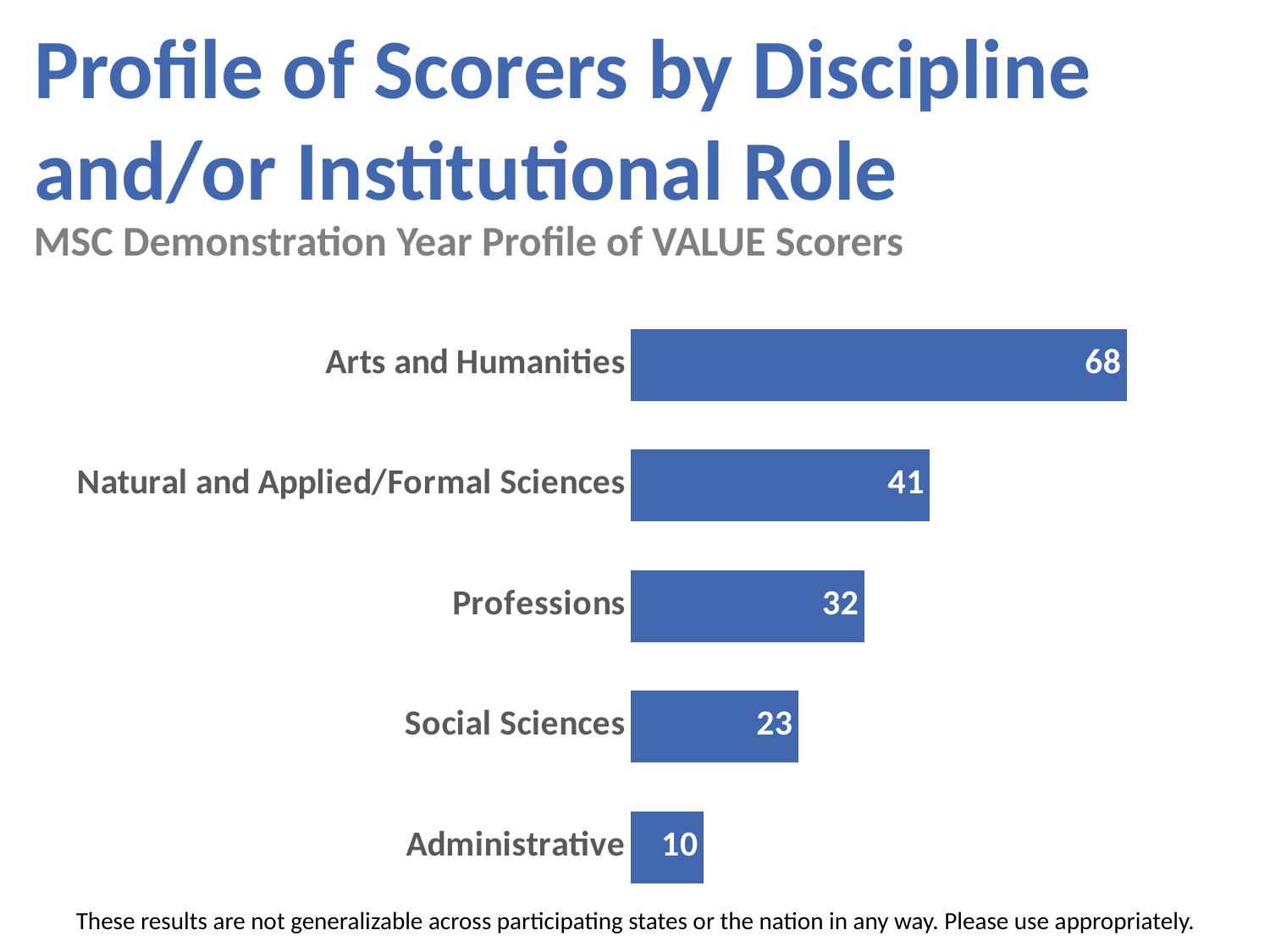
What kind of chart is shown on the slide? Bar chart Which category has the highest value? Arts and Humanities What is the value for Professions? 32 Which category has the lowest value? Administrative What is the difference between the values for Arts and Humanities and Natural and Applied/Formal Sciences? 27 How many categories are shown in the chart? 5 What is the value for Natural and Applied/Formal Sciences? 41 Which is larger, the value for Social Sciences or the value for Administrative? Social Sciences What is the difference between the values for Professions and Social Sciences? 9 What is the value for Social Sciences? 23 What is the value for Administrative? 10 What is the value for Arts and Humanities? 68